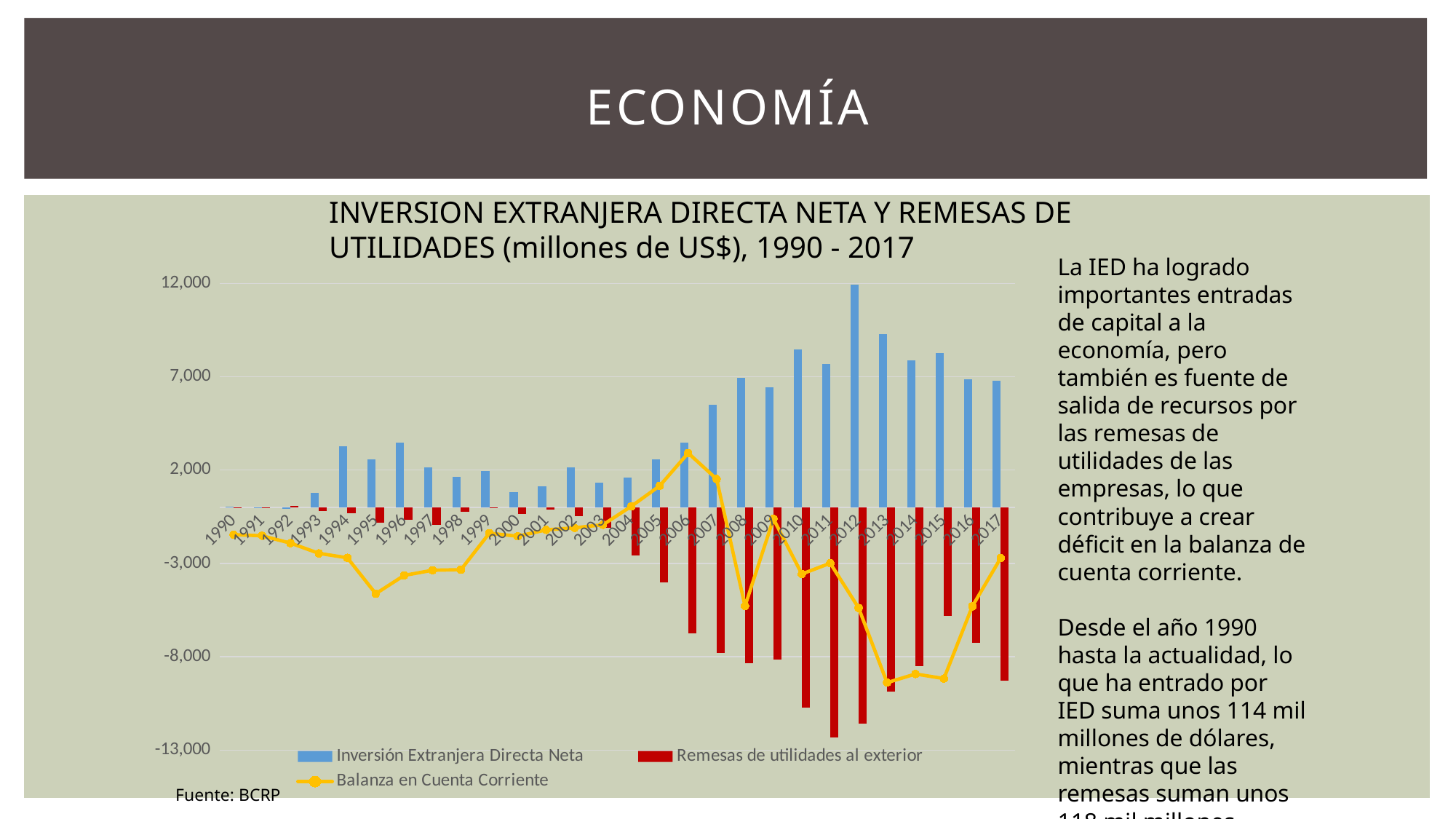
Is the Remesas de utilidades al exterior value for 2012 greater or less than -8,000? less In which year is the Remesas de utilidades al exterior bar the most negative? 2011 How many series does the chart legend list? 3 Is the Balanza en Cuenta Corriente value for 2006 greater or less than 2,000? greater Does the Balanza en Cuenta Corriente line rise or fall from 2006 to 2008? fall In which year is the Inversión Extranjera Directa Neta bar the highest? 2012 Which series is shown in red in the chart? Remesas de utilidades al exterior How many years are plotted along the x axis of the chart? 28 Is the Inversión Extranjera Directa Neta value for 2012 greater or less than 7,000? greater Which year has a larger Inversión Extranjera Directa Neta value, 2012 or 2013? 2012 What kind of chart is shown on the slide? A combination bar and line chart